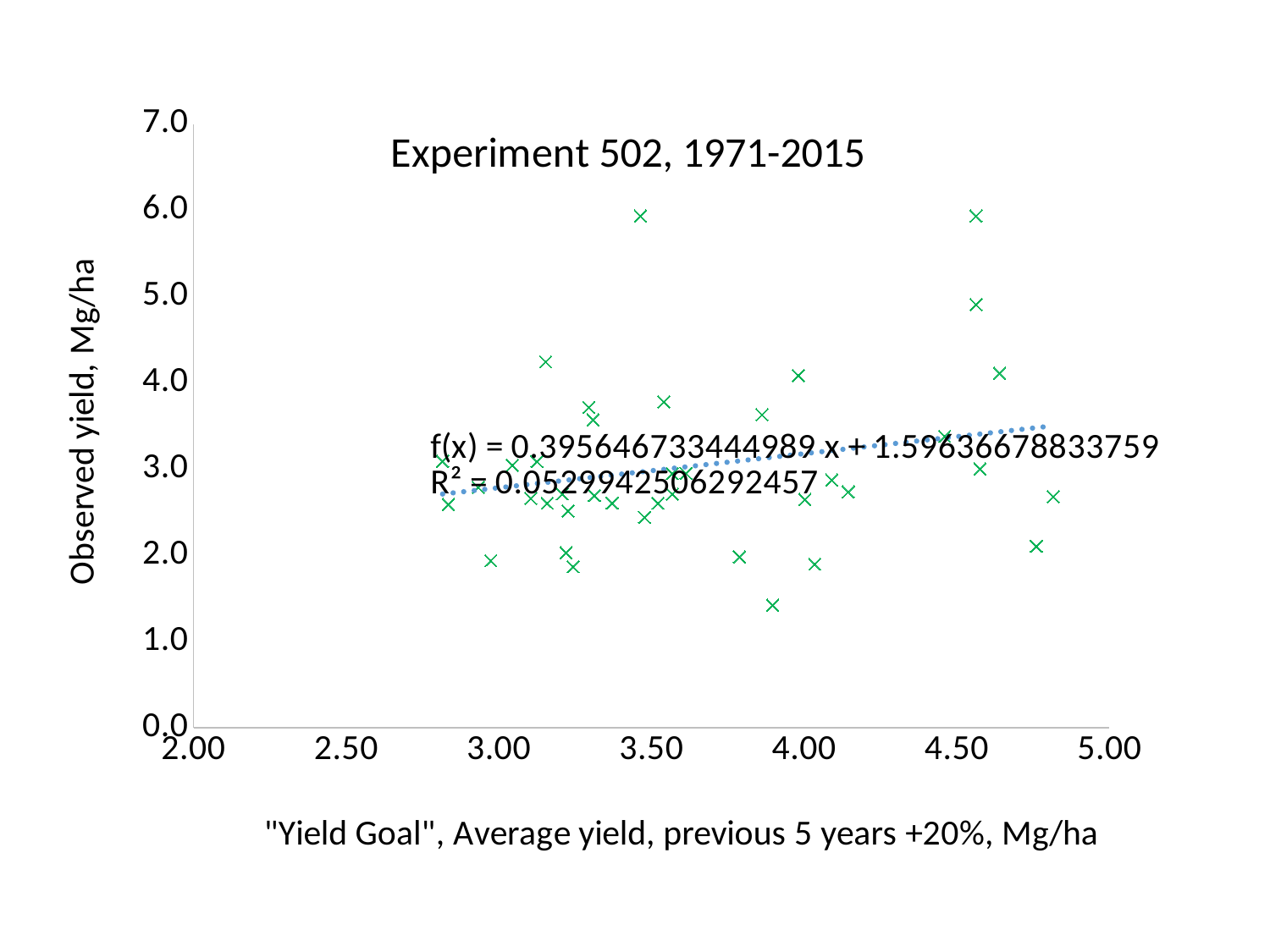
What is the slope of the fitted line f(x) shown on the chart? 0.395646733444989 What is the label of the vertical axis? Observed yield, Mg/ha What is the maximum value shown on the horizontal axis? 5.00 What is the title of the chart? Experiment 502, 1971-2015 What R² value is printed for the trendline? 0.0529942506292457 What kind of chart is shown on the slide? Scatter chart Is the lowest observed yield plotted greater or less than 2.0 Mg/ha? less According to the trendline, do observed yields rise or fall as the yield goal increases? Rise What is the maximum value shown on the vertical axis? 7.0 Is the highest observed yield plotted greater or less than 5.0 Mg/ha? greater What is the intercept of the fitted line f(x) shown on the chart? 1.59636678833759